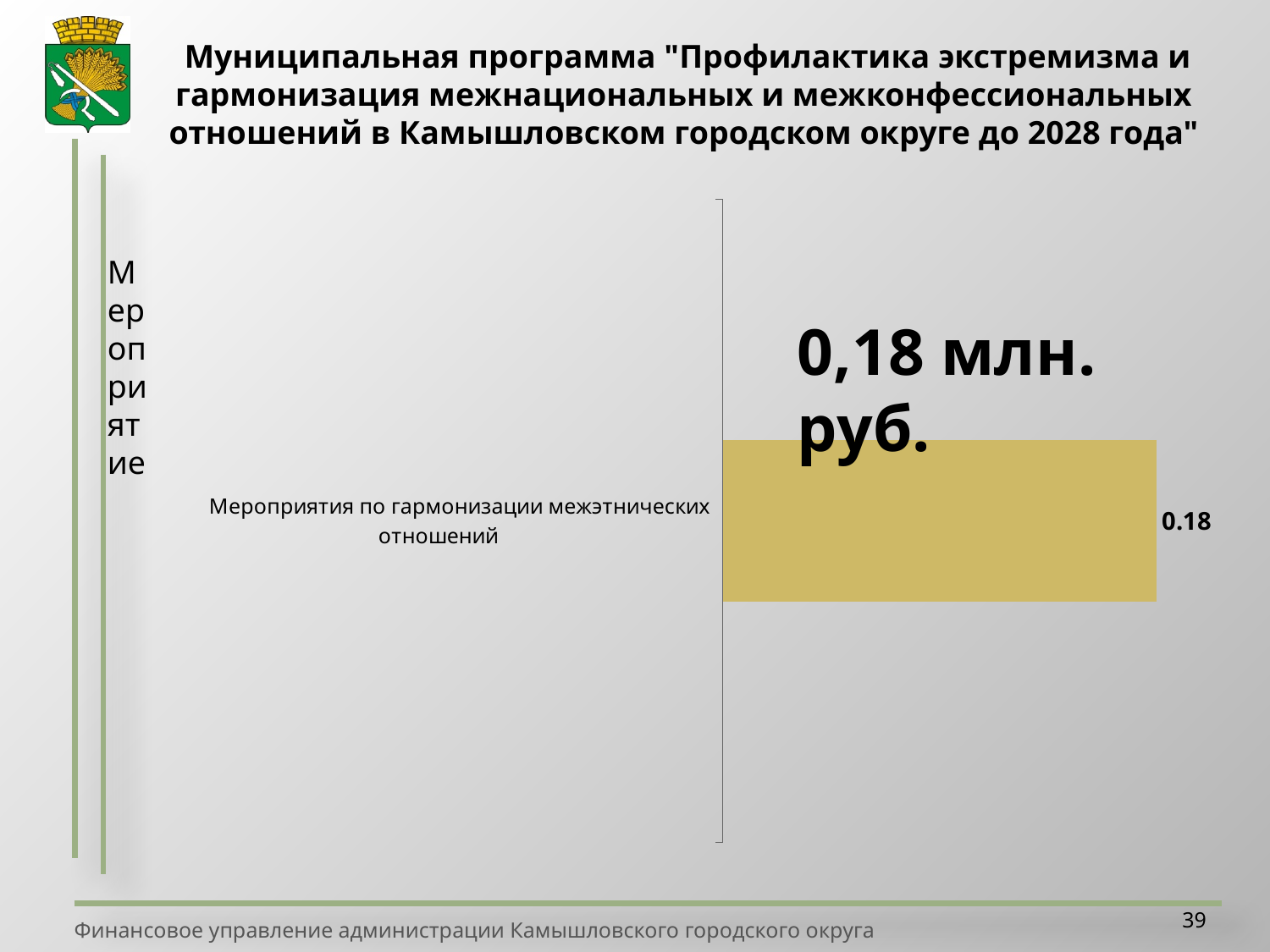
What is the value shown for "Мероприятия по гармонизации межэтнических отношений"? 0.18 What kind of chart is shown on the slide? bar chart How many categories does the chart show? 1 What is the label of the only category in the chart? Мероприятия по гармонизации межэтнических отношений Are the bars in the chart horizontal or vertical? horizontal How many bars are plotted in the chart? 1 What amount in million roubles is written in large text next to the bar? 0,18 млн. руб. What colour is the bar in the chart? yellow